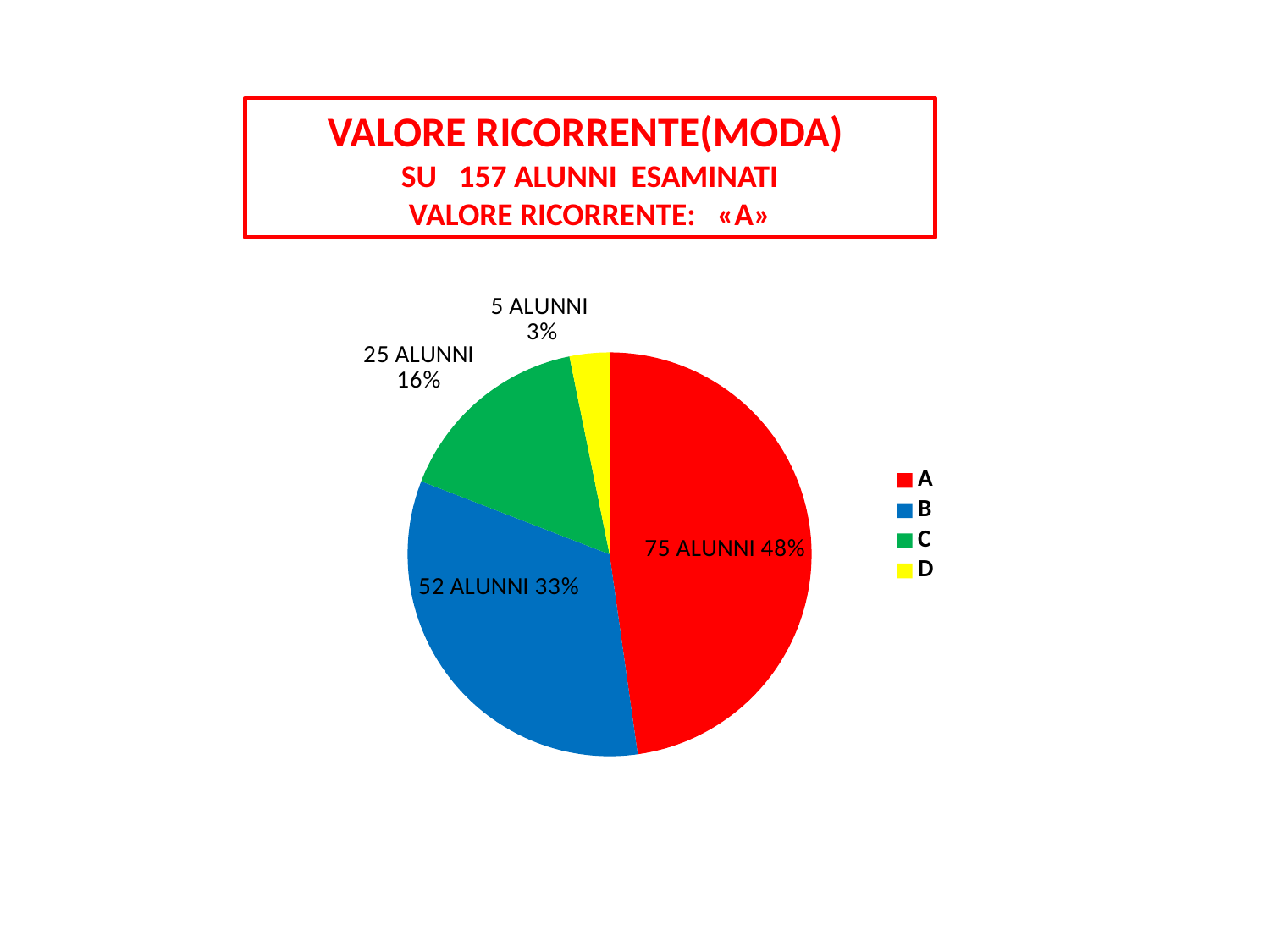
What kind of chart is shown on the slide? pie chart What colour is the slice for category C? green What percentage of the pie does category B represent? 33% How many students (alunni) are in category A? 75 ALUNNI What is the difference in number of students between category A and category B? 23 Which category has the smallest slice of the pie? D How many students are in category C? 25 ALUNNI What is the total number of students examined according to the slide title? 157 What percentage share does category D have? 3% Which category has more students, B or C? B Which category has the largest slice of the pie? A How many categories does the legend list? 4